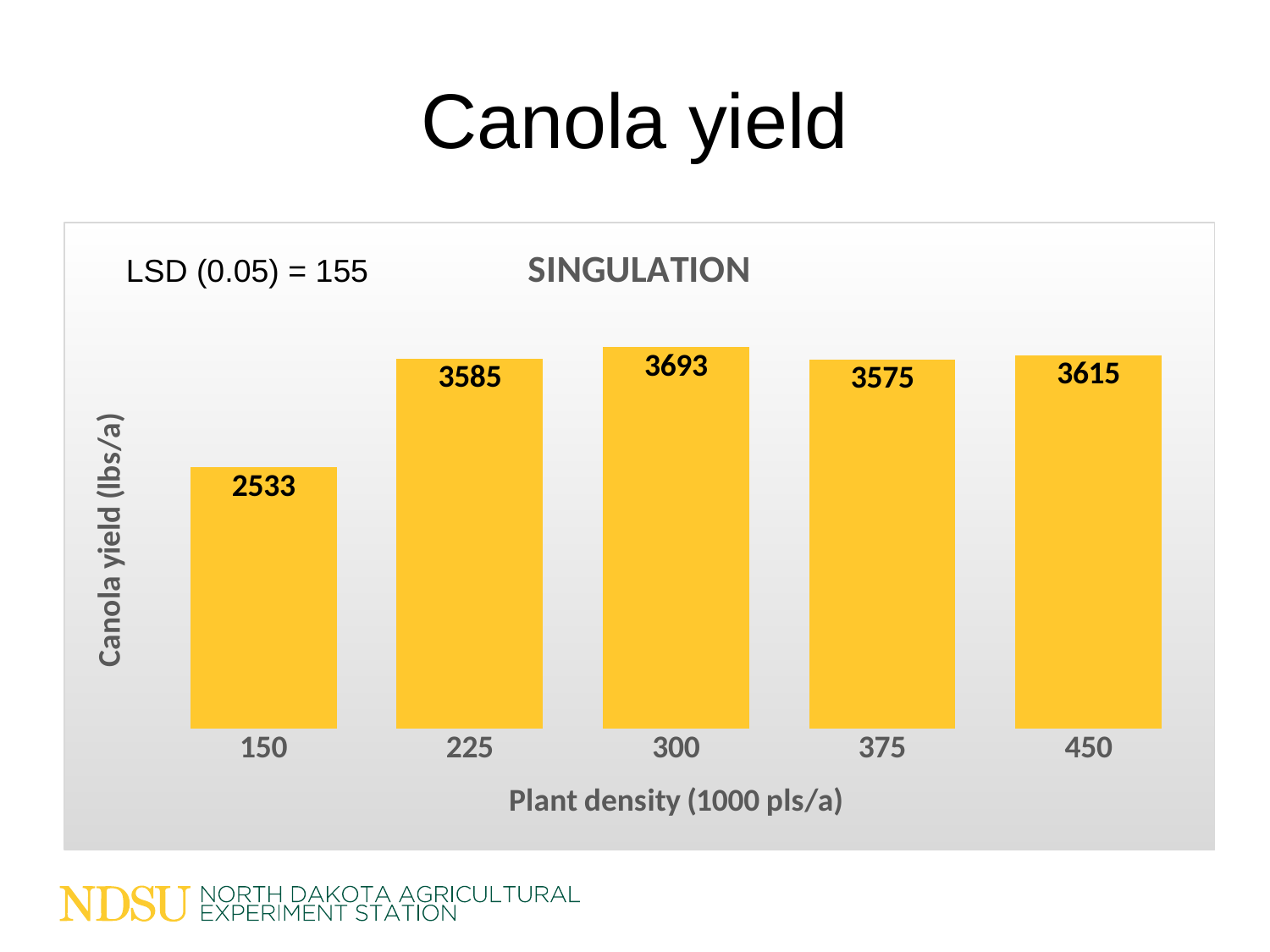
What is the difference in canola yield between plant densities of 300 and 150? 1160 Which plant density gives the lowest canola yield? 150 What LSD (0.05) value is stated on the chart? 155 Which plant density gives the highest canola yield? 300 What type of chart is shown on the slide? Bar chart What is the canola yield at a plant density of 150 (1000 pls/a)? 2533 How many plant density categories are shown in the chart? 5 What is the difference in canola yield between plant densities of 450 and 375? 40 Which has a higher canola yield, a plant density of 225 or 150? 225 What is the title shown inside the chart area? SINGULATION What is the canola yield at a plant density of 300 (1000 pls/a)? 3693 What is the canola yield at a plant density of 450 (1000 pls/a)? 3615